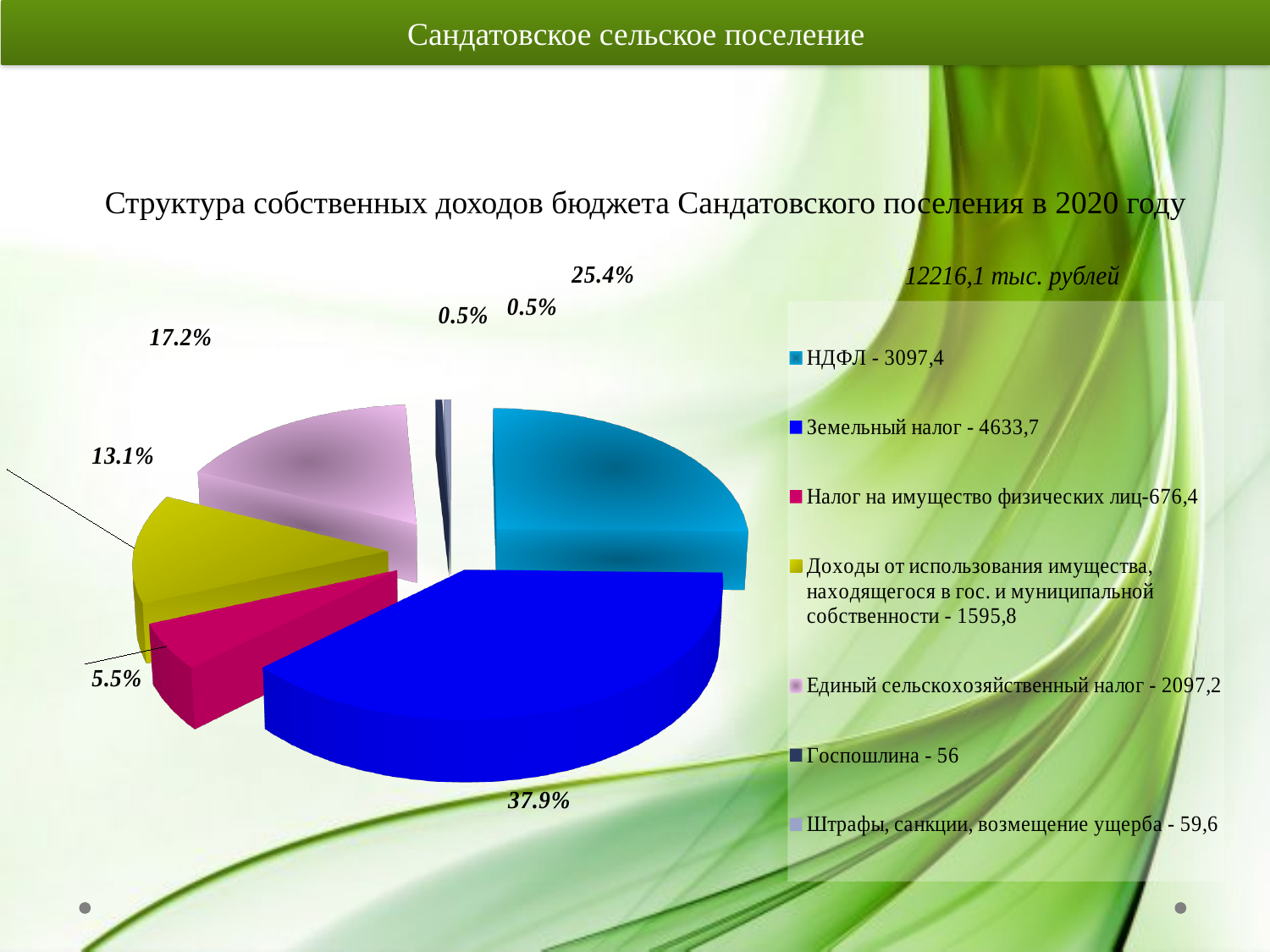
What is the value for Единый сельскохозяйственный налог shown in the legend? 2097,2 How many categories does the legend of the pie chart list? 7 What is the title of the chart? Структура собственных доходов бюджета Сандатовского поселения в 2020 году Which category has the largest share of the pie? Земельный налог What percentage share of the pie does Земельный налог have? 37.9% What kind of chart is shown on the slide? pie chart Which is larger: the value for Доходы от использования имущества or the value for Налог на имущество физических лиц? Доходы от использования имущества What percentage share of the pie does Налог на имущество физических лиц have? 5.5% What is the value for НДФЛ shown in the legend? 3097,4 What is the difference between the values for Земельный налог and НДФЛ? 1536,3 What total amount in thousand rubles is shown above the legend? 12216,1 тыс. рублей Which category has the smallest value according to the legend? Госпошлина